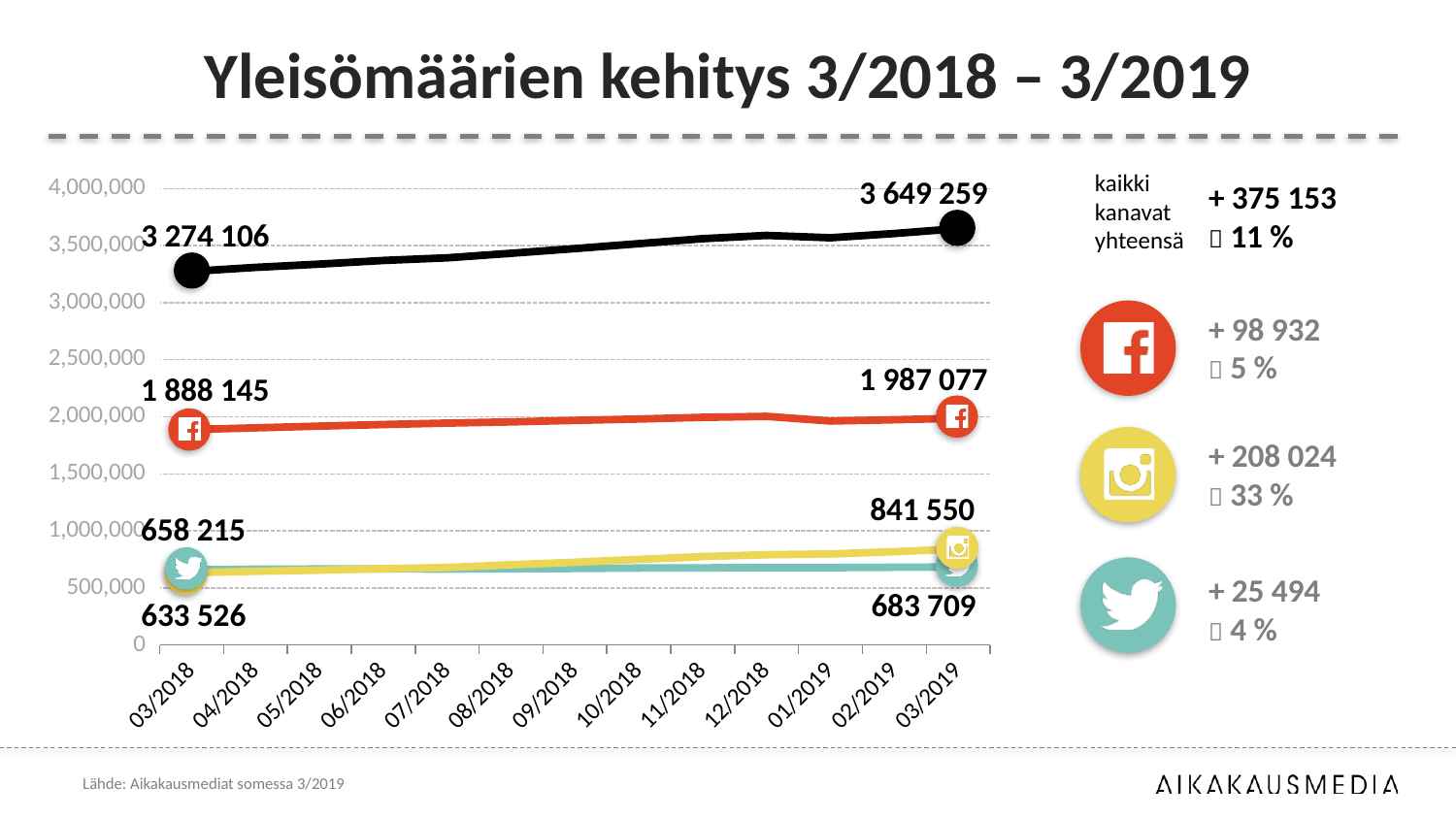
What is the value of the Twitter (teal) line at 03/2019? 683 709 Which line has the lowest value at 03/2019? the Twitter (teal) line What is the value of the black (total) line at 03/2019? 3 649 259 What is the value of the Facebook (red) line at 03/2018? 1 888 145 What is the value of the black (total) line at 03/2018? 3 274 106 How many months are shown on the x axis? 13 What is the value of the Instagram (yellow) line at 03/2019? 841 550 Which line has the highest value at 03/2019? the black (total) line What is the value of the Facebook (red) line at 03/2019? 1 987 077 By how much did the black (total) line increase from 03/2018 to 03/2019? 375 153 What type of chart is shown on the slide? line chart By how much did the Facebook (red) line increase from 03/2018 to 03/2019? 98 932